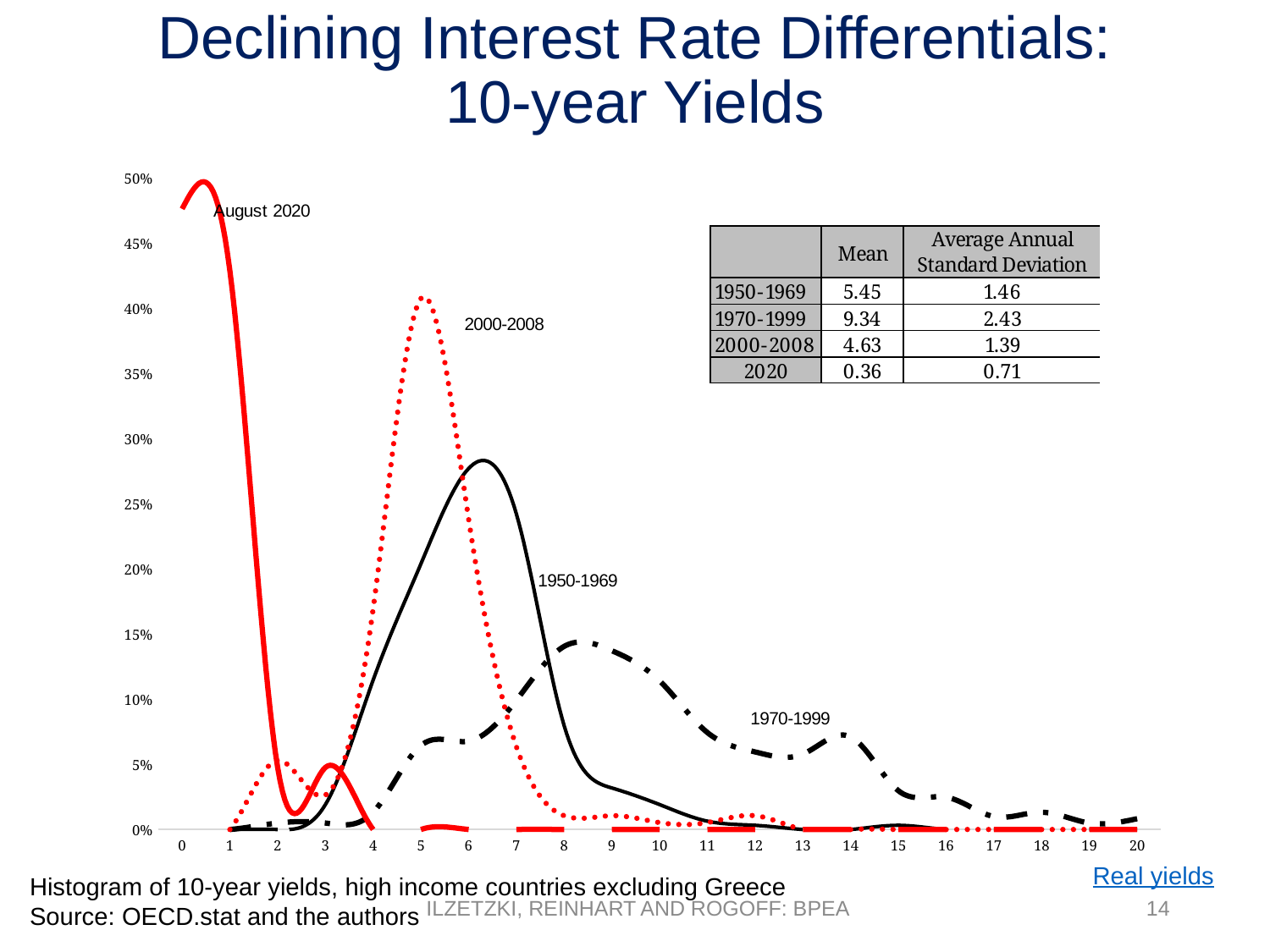
Is the peak of the 2000-2008 series greater or less than 35%? greater Which series has the highest peak on the chart? August 2020 Is the peak of the 1950-1969 series greater or less than 30%? less Which series peaks higher, 2000-2008 or 1950-1969? 2000-2008 Does the August 2020 series rise or fall as the yield moves from 1 to 3 on the x axis? fall What is the highest value shown on the y axis? 50% What kind of chart is shown on the slide? line chart Is the peak of the August 2020 series greater or less than 45%? greater How many series (distributions) are plotted on the chart? 4 What is the highest value shown on the x axis? 20 Which series has the lowest peak on the chart? 1970-1999